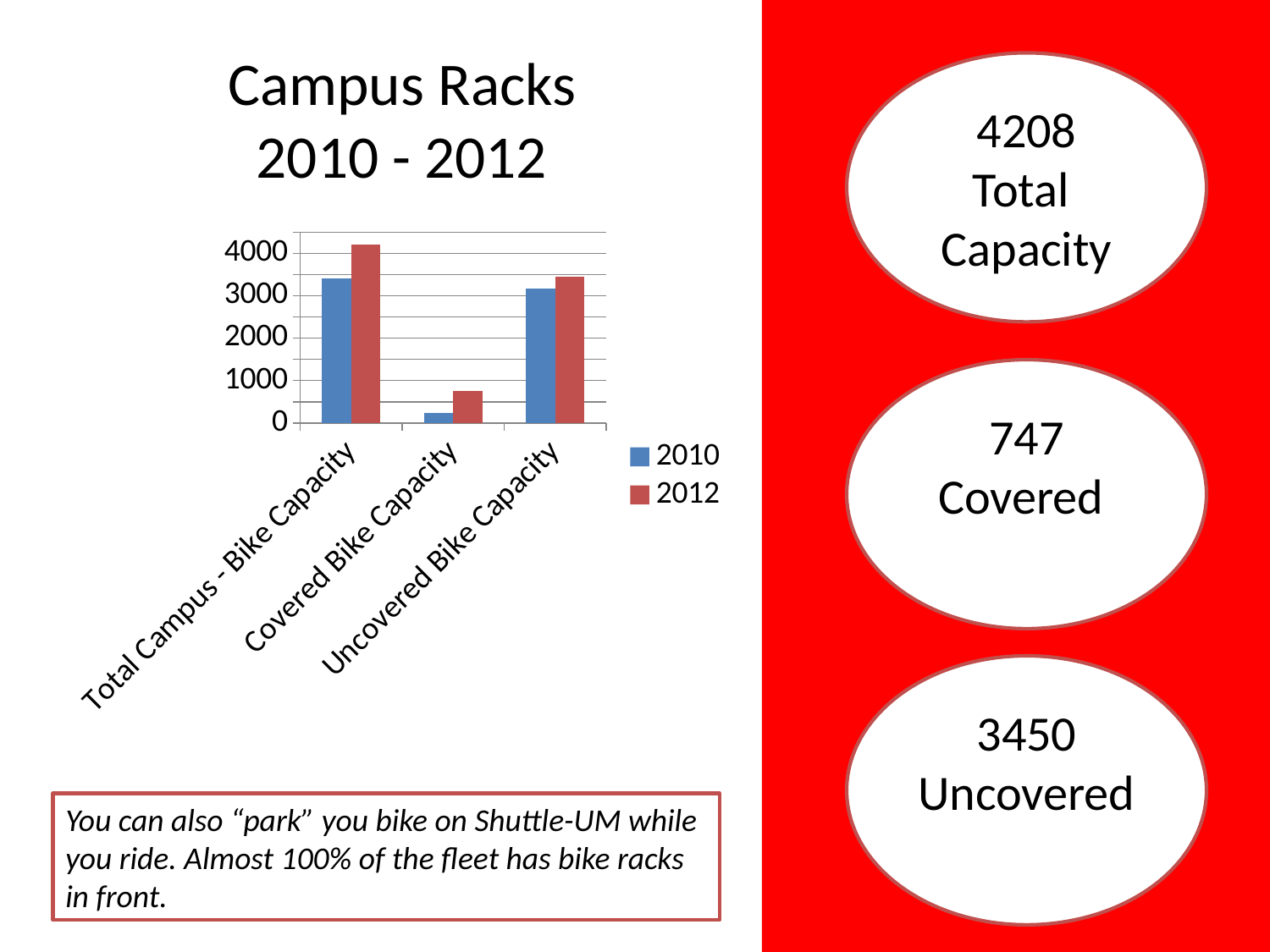
Which category has the highest 2012 value? Total Campus - Bike Capacity What is the title of the chart? Campus Racks 2010 - 2012 How many categories are shown on the x axis of the chart? 3 For Total Campus - Bike Capacity, which is larger: the 2010 value or the 2012 value? 2012 Is the 2012 value for Uncovered Bike Capacity greater or less than 3000? greater Which category has the lowest 2010 value? Covered Bike Capacity Is the 2012 value for Total Campus - Bike Capacity greater or less than 4000? greater Which series are listed in the chart legend? 2010 and 2012 How many series does the chart legend list? 2 For Covered Bike Capacity, which is larger: the 2010 value or the 2012 value? 2012 Is the 2012 value for Covered Bike Capacity greater or less than 1000? less What kind of chart is shown on the slide? bar chart